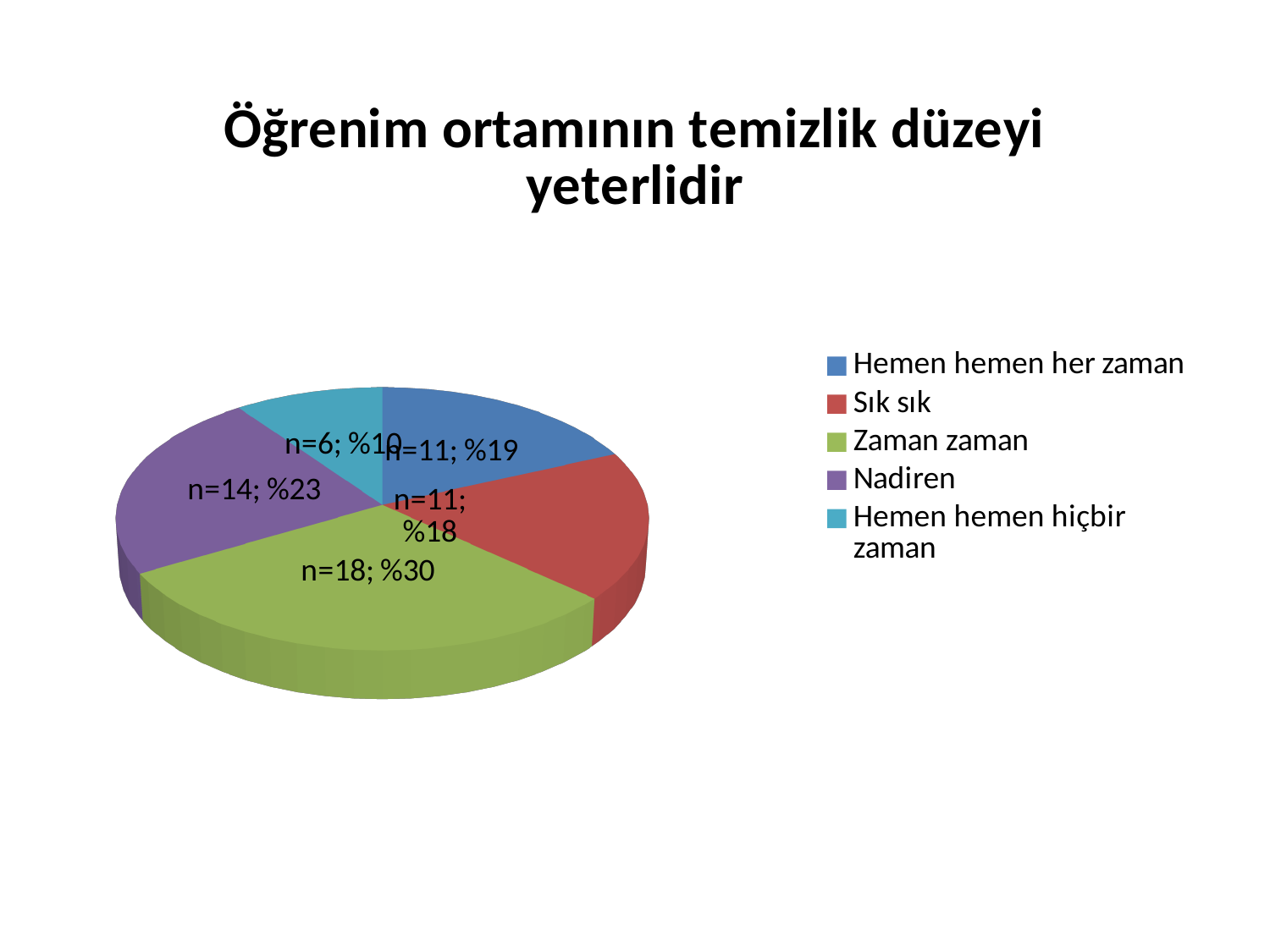
Which category has the largest slice? Zaman zaman What is the data label for the 'Zaman zaman' slice? n=18; %30 What is the title of the chart? Öğrenim ortamının temizlik düzeyi yeterlidir What percentage share does 'Hemen hemen her zaman' have? %19 What percentage share does 'Sık sık' have? %18 How many slices does the pie chart have? 5 Which category has the smallest slice? Hemen hemen hiçbir zaman What kind of chart is shown on the slide? pie chart What is the difference in n between 'Zaman zaman' and 'Nadiren'? 4 How many entries does the legend list? 5 What is the n value for 'Hemen hemen hiçbir zaman'? n=6 What is the data label for the 'Nadiren' slice? n=14; %23